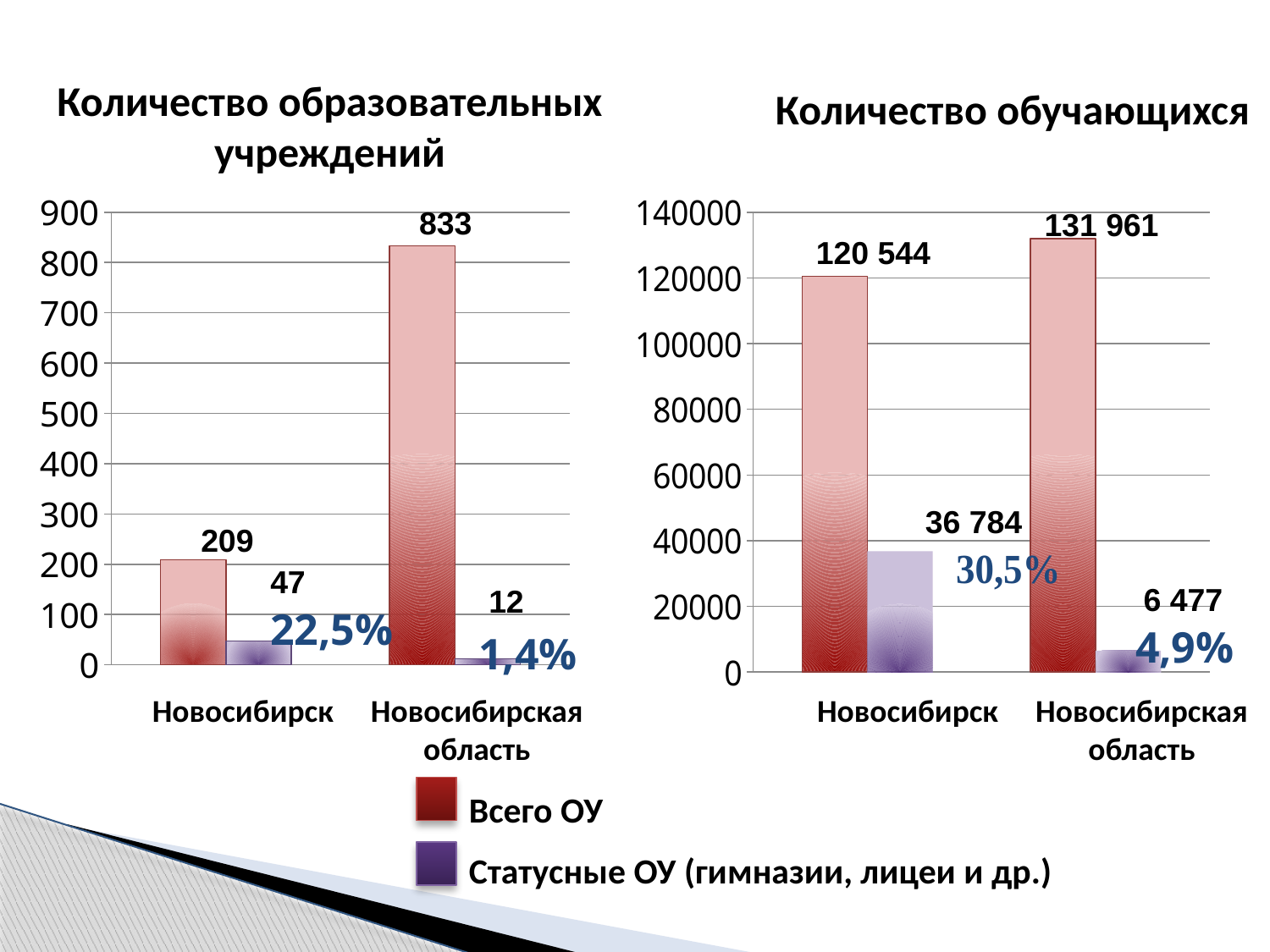
In the chart 'Количество обучающихся', is 'Всего ОУ' for Новосибирск greater or less than 100000? greater What kind of chart is 'Количество обучающихся'? bar chart In the chart 'Количество обучающихся', what is the value of 'Статусные ОУ' for Новосибирск? 36 784 In the chart 'Количество образовательных учреждений', what is the value of 'Статусные ОУ' for Новосибирская область? 12 In the chart 'Количество образовательных учреждений', which bar is the highest? Всего ОУ, Новосибирская область In the chart 'Количество обучающихся', which bar is the lowest? Статусные ОУ, Новосибирская область In the chart 'Количество образовательных учреждений', what is the difference between 'Всего ОУ' for Новосибирская область and for Новосибирск? 624 In the chart 'Количество обучающихся', what is the difference between 'Статусные ОУ' for Новосибирск and for Новосибирская область? 30 307 In the chart 'Количество образовательных учреждений', which is larger: 'Статусные ОУ' for Новосибирск or for Новосибирская область? Новосибирск In the chart 'Количество обучающихся', what is the value of 'Всего ОУ' for Новосибирская область? 131 961 In the chart 'Количество образовательных учреждений', what is the value of 'Всего ОУ' for Новосибирск? 209 How many series does the shared legend list? 2